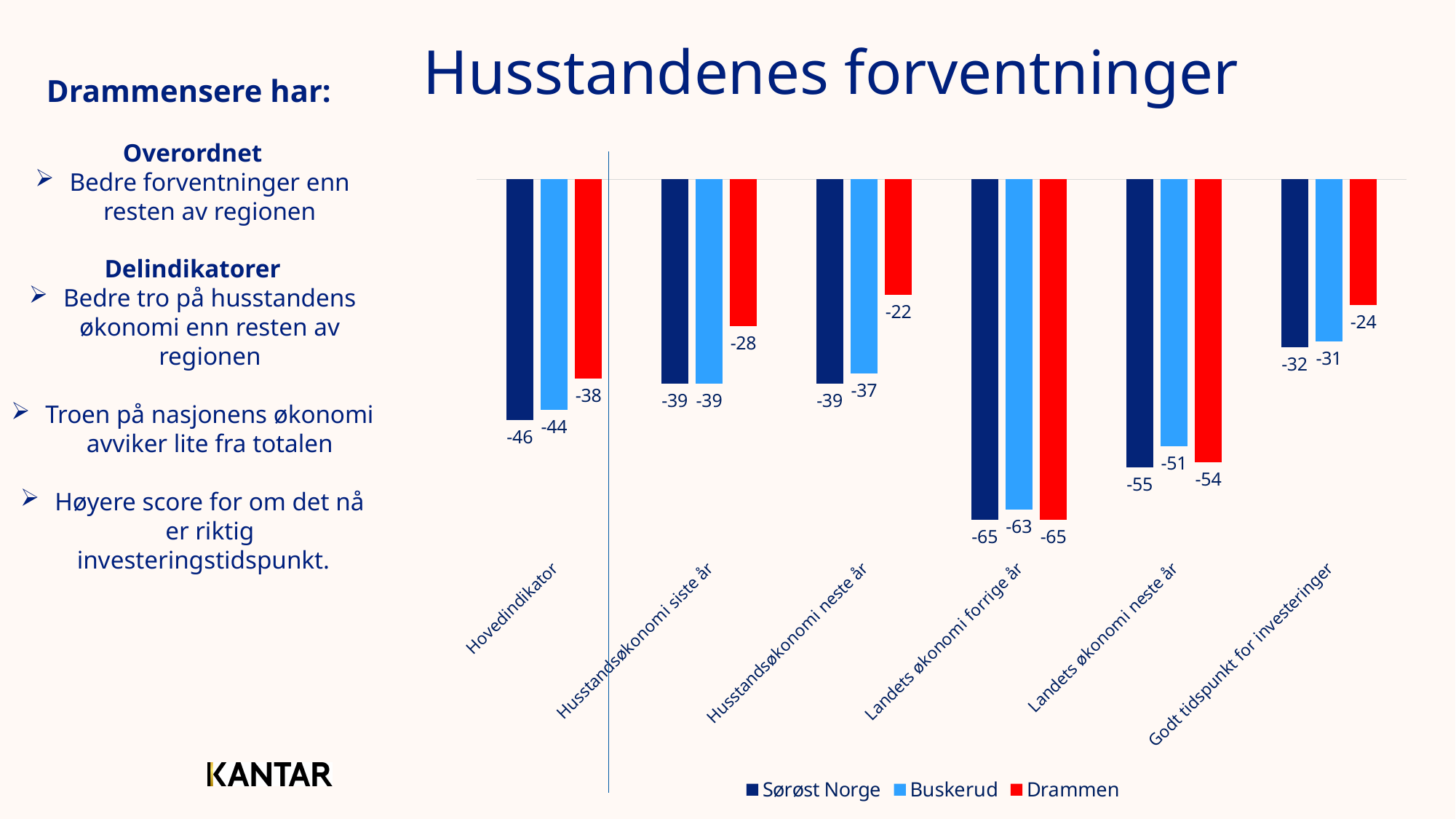
What is the difference between the Sørøst Norge and Drammen values in the Husstandsøkonomi neste år category? 17 What kind of chart is shown on the slide? Bar chart In the Hovedindikator category, which is larger: the value for Sørøst Norge or the value for Drammen? Drammen What is the value for Drammen in the Godt tidspunkt for investeringer category? -24 What is the value for Buskerud in the Husstandsøkonomi neste år category? -37 Which category has the lowest value for Drammen? Landets økonomi forrige år Which series is shown in red? Drammen How many categories are shown on the x axis? 6 Which category has the highest value for Drammen? Husstandsøkonomi neste år What is the value for Sørøst Norge in the Landets økonomi neste år category? -55 What is the value for Drammen in the Hovedindikator category? -38 How many series does the legend list? 3